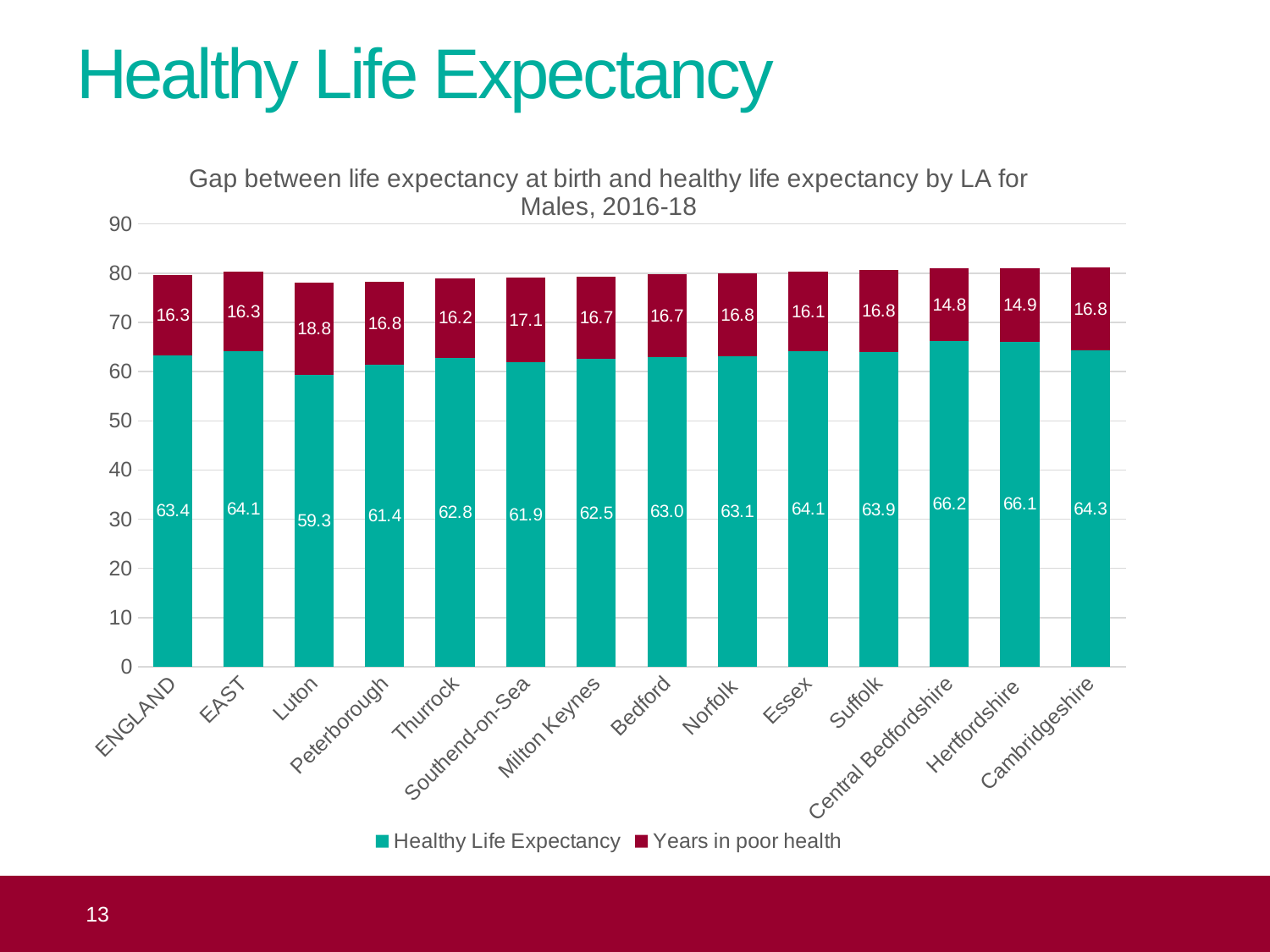
Which has a higher Healthy Life Expectancy, Essex or Suffolk? Essex How many categories are shown on the x axis? 14 What is the total height of the stacked bar for Luton? 78.1 What is the Healthy Life Expectancy value for Luton? 59.3 Which category has the highest Healthy Life Expectancy value? Central Bedfordshire What is the Healthy Life Expectancy value for ENGLAND? 63.4 Is the Healthy Life Expectancy value for Luton greater or less than 60? less Which category has the highest Years in poor health value? Luton Which local authority has the lowest Healthy Life Expectancy? Luton What is the Years in poor health value for Central Bedfordshire? 14.8 How many series does the legend list? 2 What is the difference between the Years in poor health values for Luton and ENGLAND? 2.5